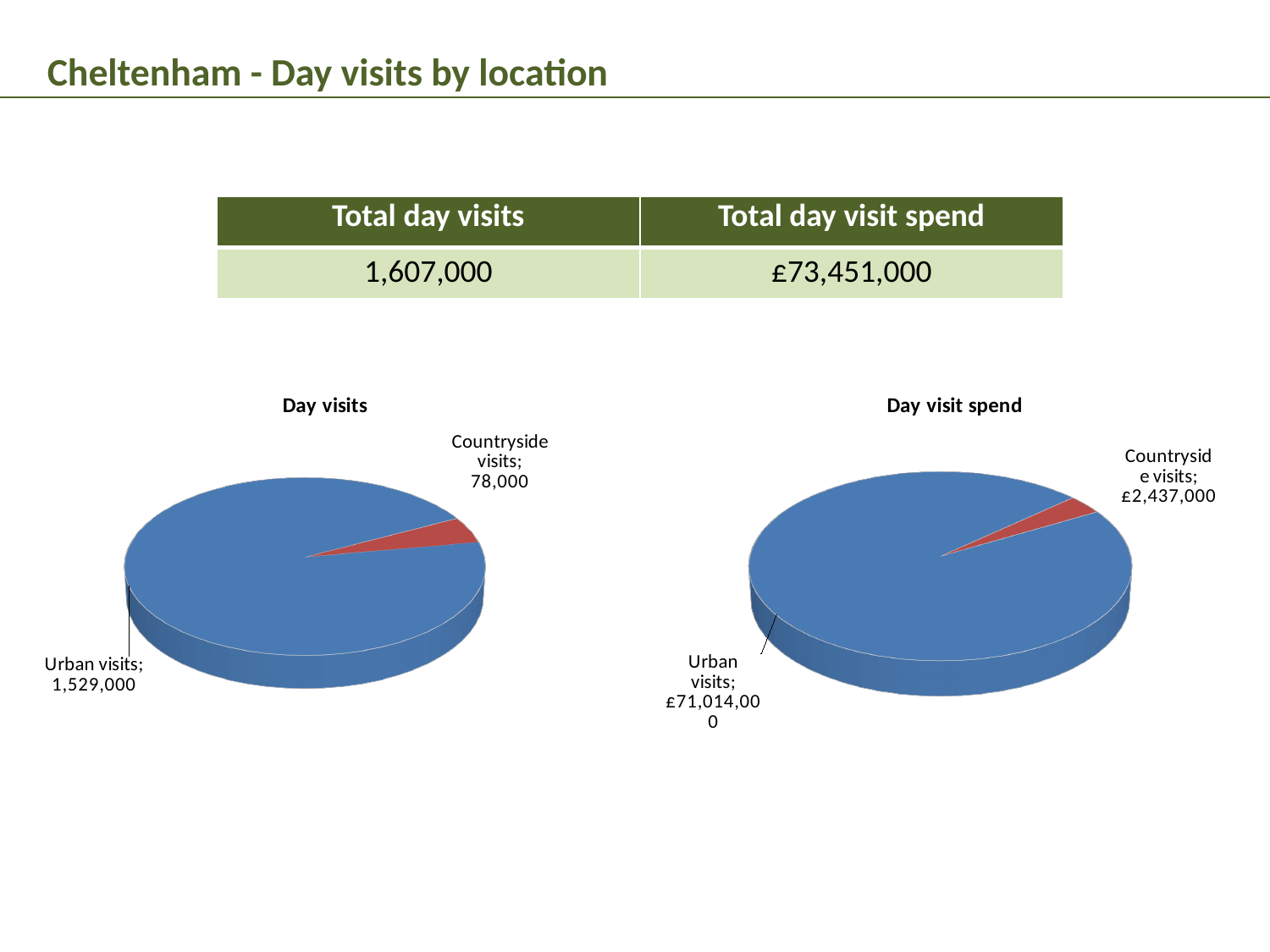
In the Day visit spend chart, what is the value for Countryside visits? £2,437,000 How many slices does the Day visits chart have? 2 In the Day visit spend chart, which is larger: Urban visits or Countryside visits? Urban visits In the Day visits chart, what is the value for Countryside visits? 78,000 In the Day visits chart, what is the difference between Urban visits and Countryside visits? 1,451,000 In the Day visit spend chart, what is the difference between Urban visits and Countryside visits? £68,577,000 In the Day visits chart, what is the value for Urban visits? 1,529,000 In the Day visits chart, what colour is the Countryside visits slice? Red In the Day visit spend chart, which category has the smallest slice? Countryside visits In the Day visits chart, which category has the largest slice? Urban visits What kind of chart is the Day visit spend chart? Pie chart In the Day visit spend chart, what is the value for Urban visits? £71,014,000